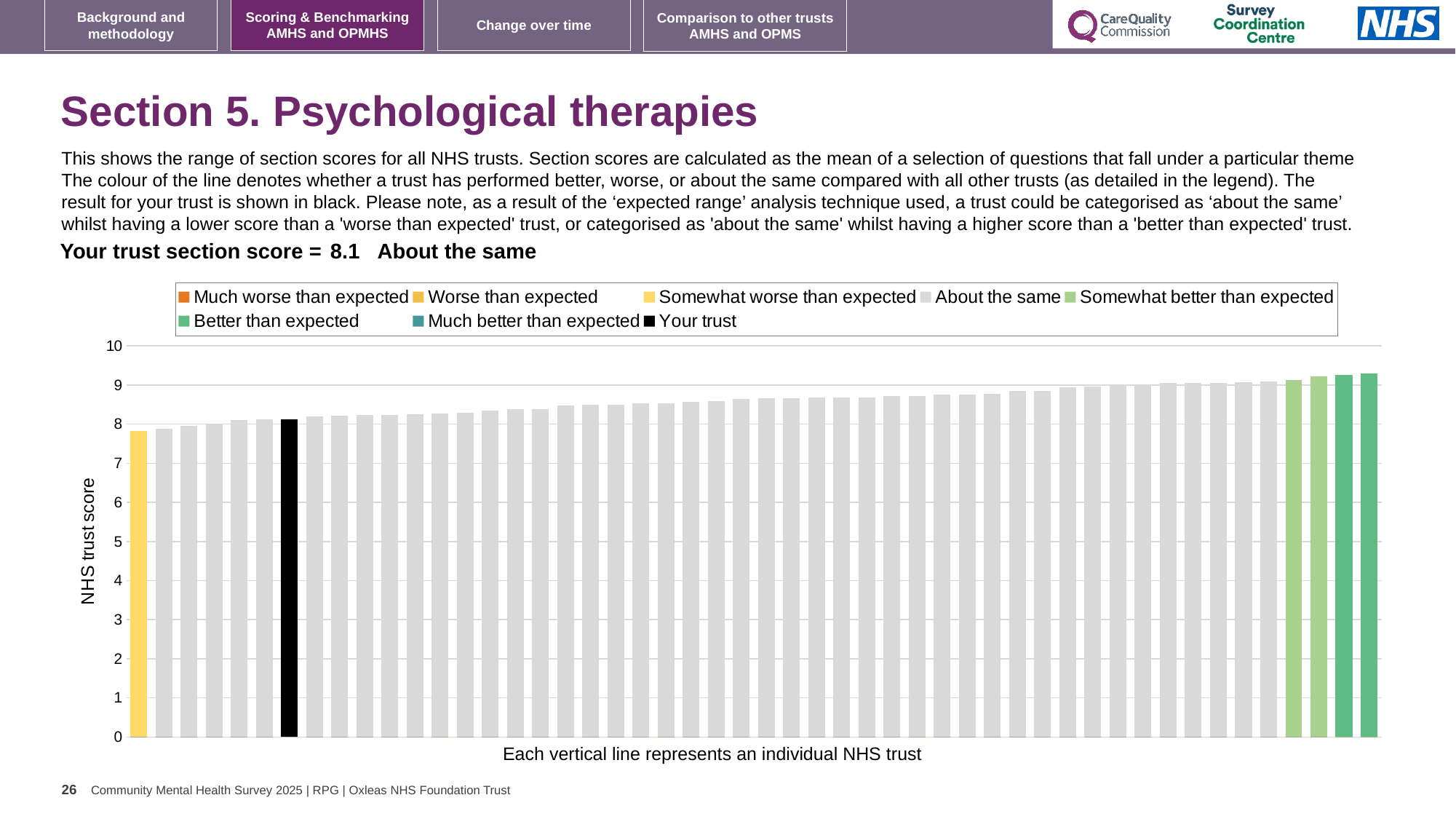
What is the section score for your trust shown on the slide? 8.1 Which bar is the highest in the chart? The rightmost bar Is the value for your trust greater or less than 9? less What colour is the bar representing your trust? Black How many entries does the chart legend list? 8 What is the title of the y axis? NHS trust score Do the bar values rise or fall from left to right along the x axis? rise Is the value for your trust greater or less than 5? greater Is the value of the leftmost (lowest) bar greater or less than 8? less What kind of chart is shown on the slide? Bar chart Which category is your trust placed in for this section? About the same